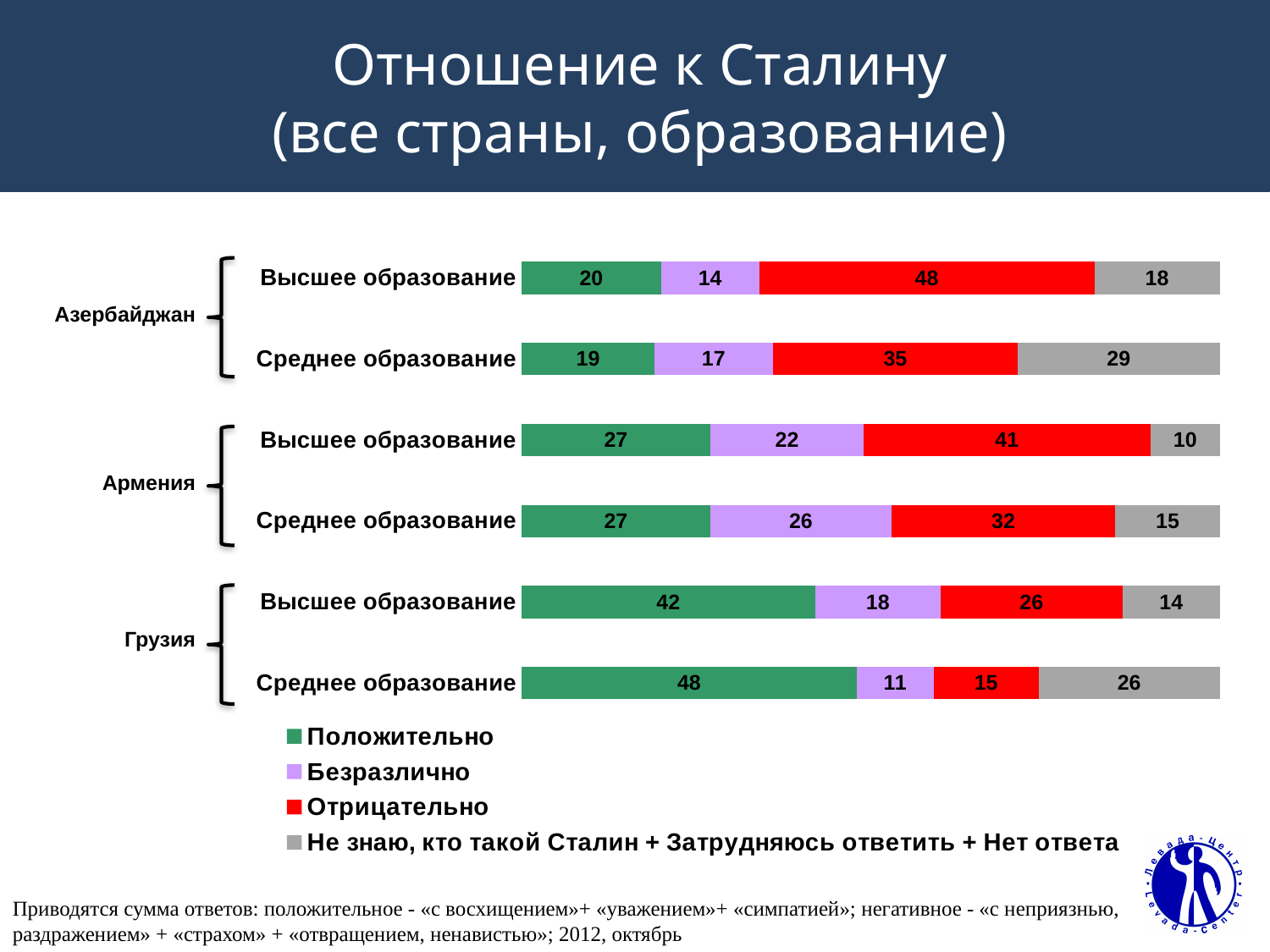
Which bar has the highest "Положительно" value? Грузия, Среднее образование How many series does the legend list? 4 What kind of chart is shown on the slide? Stacked bar chart What is the value of the "Не знаю, кто такой Сталин + Затрудняюсь ответить + Нет ответа" segment for Азербайджан, Среднее образование? 29 What is the difference between the "Отрицательно" values for Азербайджан Высшее образование and Азербайджан Среднее образование? 13 What colour represents the "Отрицательно" series in the legend? Red What is the total of the stacked bar for Армения, Высшее образование? 100 How many bars are shown in the chart? 6 What is the value of the "Отрицательно" segment for Азербайджан, Среднее образование? 35 Which is larger: the "Безразлично" value for Армения Среднее образование or for Грузия Высшее образование? Армения, Среднее образование What is the value of the "Положительно" segment for Грузия, Высшее образование? 42 Which bar has the lowest "Отрицательно" value? Грузия, Среднее образование